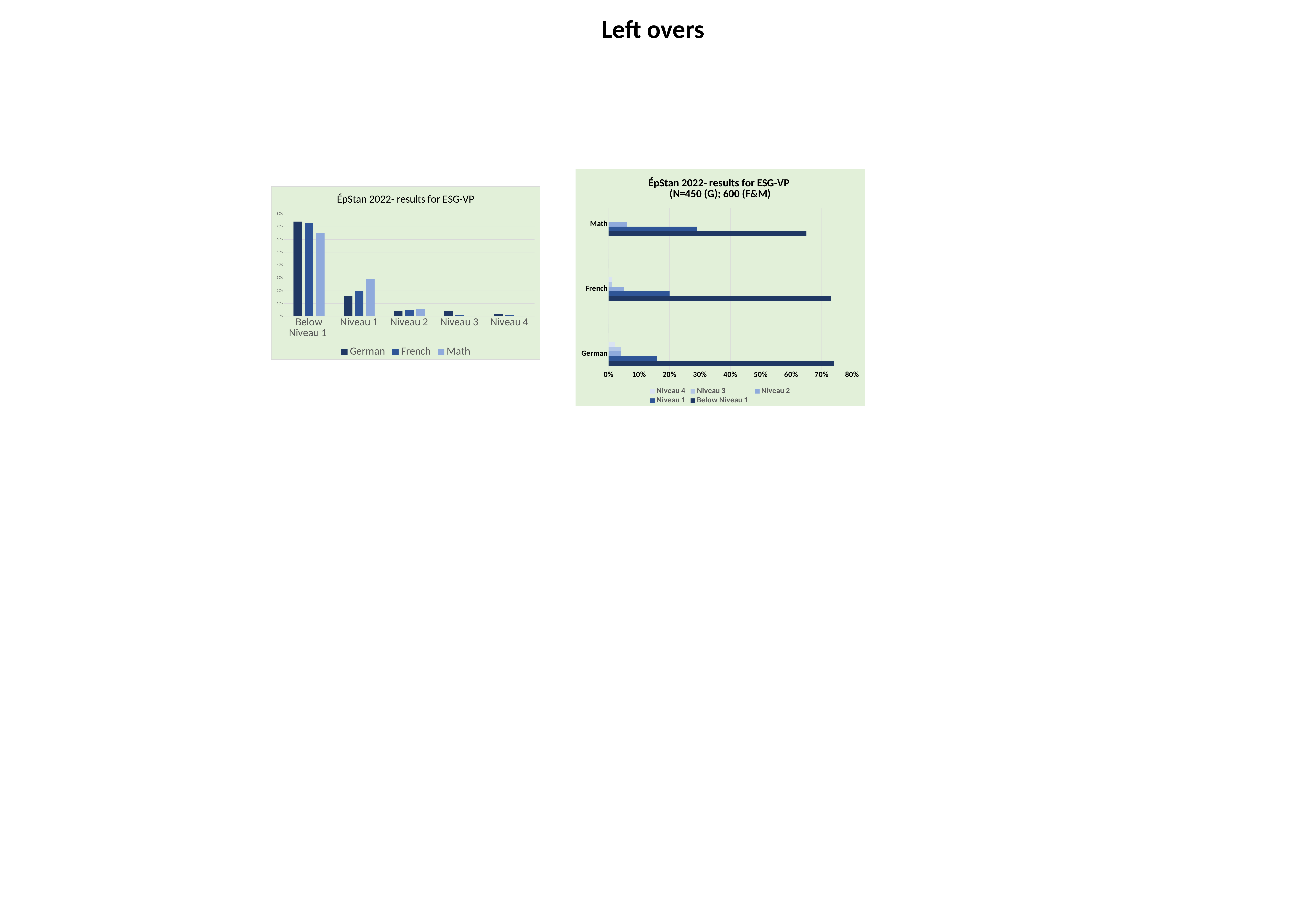
In the left chart, is the German value for Below Niveau 1 greater or less than 70%? greater In the left chart, for Niveau 1, which is larger: the Math value or the German value? Math In the right chart, is the Niveau 1 value for German greater or less than 20%? less In the left chart, which category has the highest bars for all three series? Below Niveau 1 In the left chart, how many categories are shown on the x axis? 5 In the right chart, how many series does the legend list? 5 In the right chart, how many categories are shown on the vertical axis? 3 In the left chart, how many series does the legend list? 3 In the right chart, which subject has the shortest Below Niveau 1 bar? Math What type of chart is the left chart titled 'ÉpStan 2022- results for ESG-VP'? bar chart In the left chart, is the Math value for Below Niveau 1 greater or less than 70%? less What type of chart is the right chart titled 'ÉpStan 2022- results for ESG-VP (N=450 (G); 600 (F&M)'? bar chart